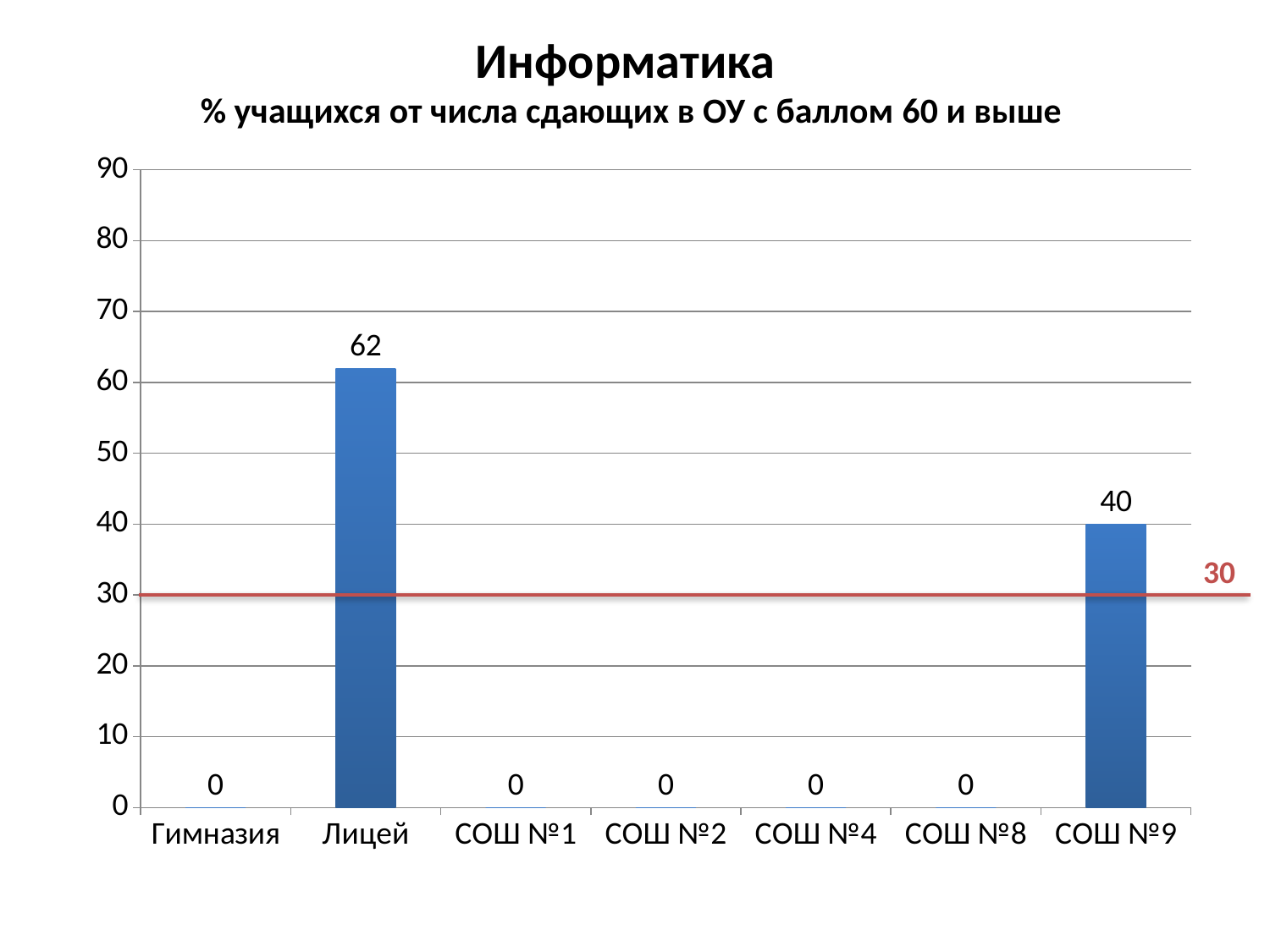
What kind of chart is shown on the slide? bar chart What is the value for СОШ №9? 40 Which category has the highest value? Лицей What is the title of the chart? Информатика What value is marked by the red horizontal line? 30 How many categories have a value of 0? 5 Is the value for СОШ №9 greater or less than 30? greater What is the value for Лицей? 62 What is the value for Гимназия? 0 Which is larger, the value for Лицей or the value for СОШ №9? Лицей How many categories are shown on the x axis? 7 What is the difference between the values for Лицей and СОШ №9? 22